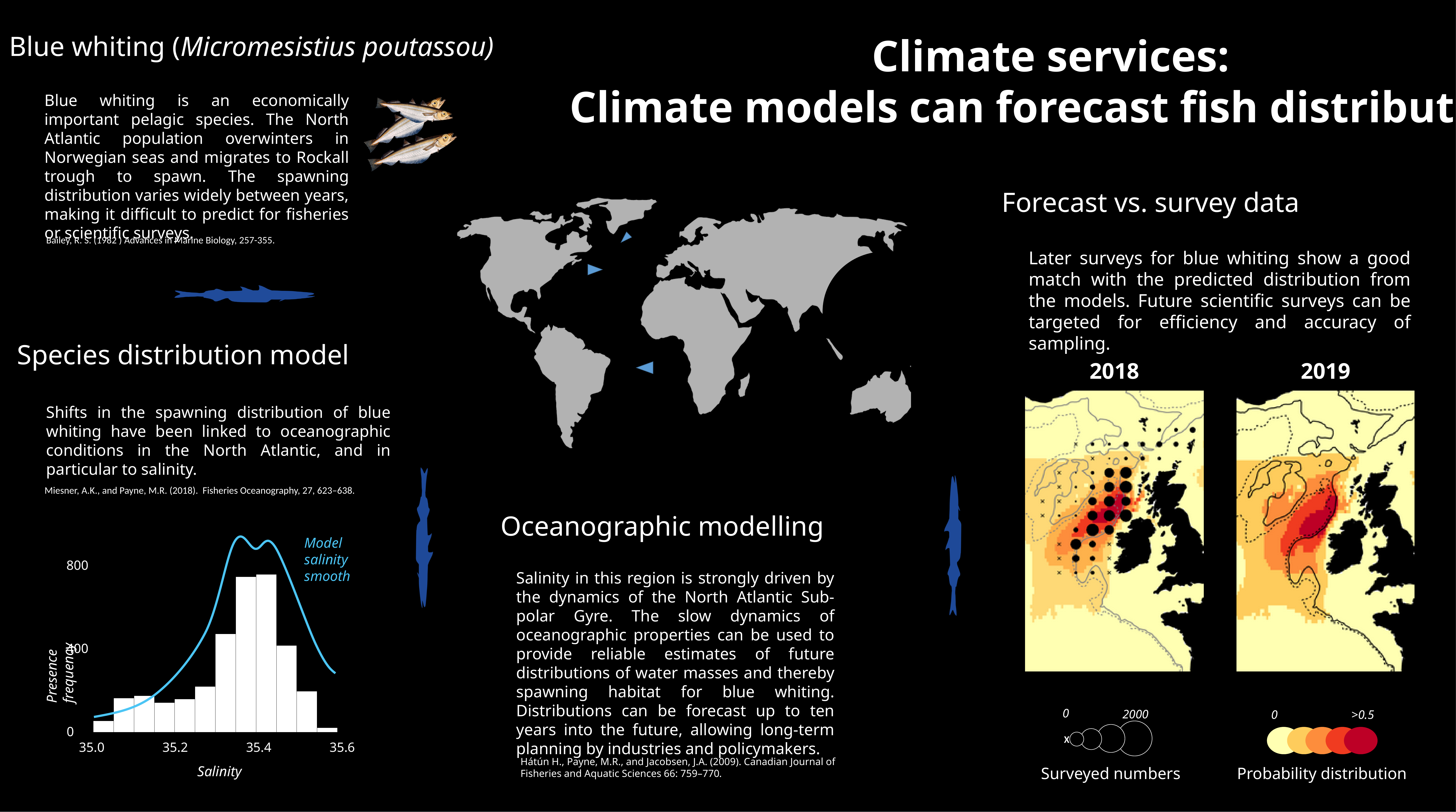
In the presence frequency chart, is the bar between 35.5 and 35.55 greater or less than 400? less In the presence frequency chart, are the two tallest bars (around 35.4) greater or less than 400? greater How many bars are plotted in the presence frequency chart? 12 In the presence frequency chart, which bar is taller: the one between 35.35 and 35.4 or the one between 35.25 and 35.3? the bar between 35.35 and 35.4 In the presence frequency chart, do the bars generally rise or fall as salinity increases from 35.0 to 35.4? rise In the presence frequency chart, is the bar between 35.2 and 35.25 greater or less than 400? less In the presence frequency chart, what is the blue curve labelled? Model salinity smooth What kind of chart is the Species distribution model chart showing presence frequency against salinity? bar chart In the presence frequency chart, what is the label of the x axis? Salinity In the presence frequency chart, do the bars rise or fall as salinity increases from 35.45 to 35.6? fall What is the highest value shown on the y axis of the presence frequency chart? 800